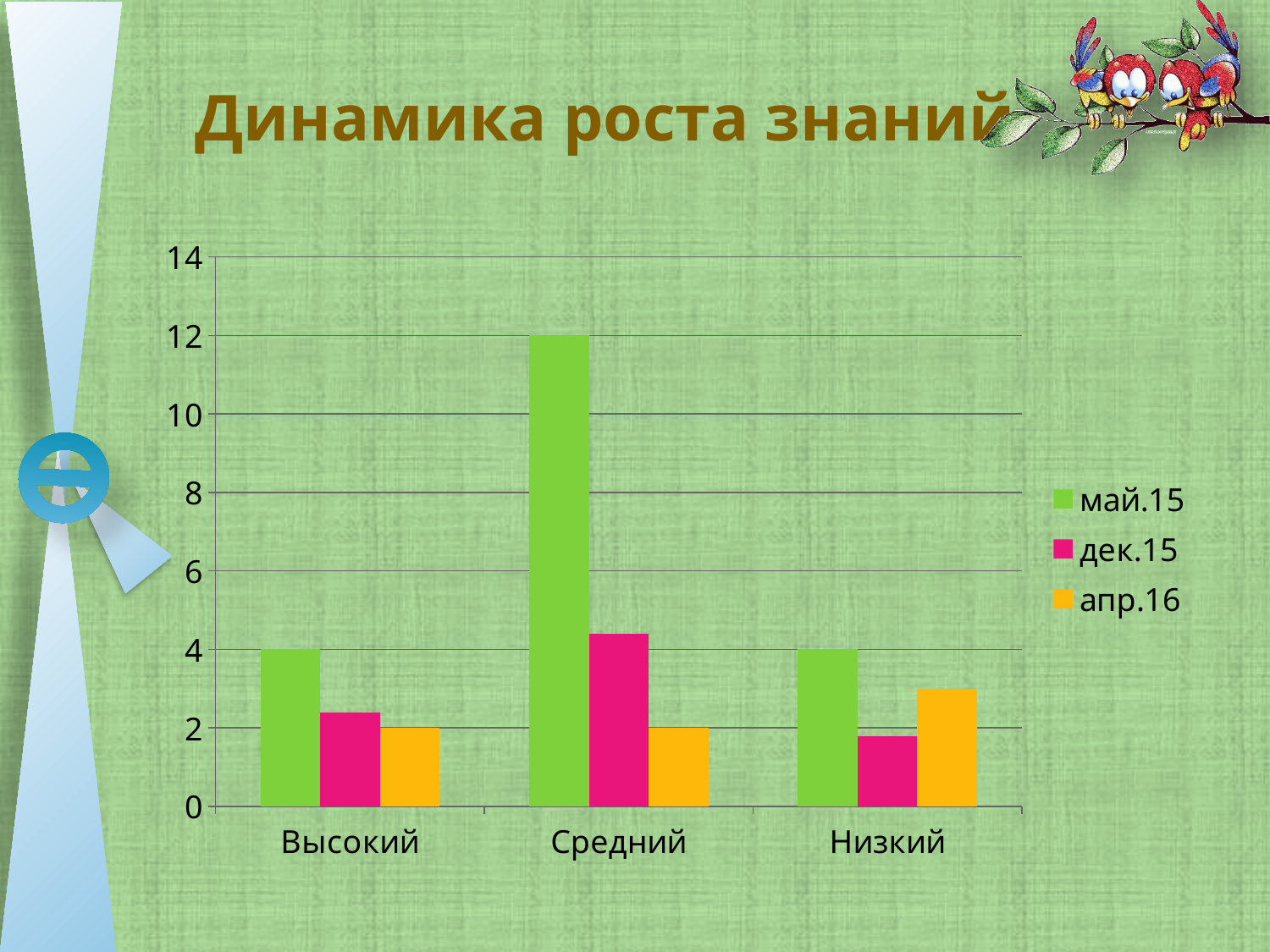
Is the value for апр.16 in the Низкий category greater or less than 2? greater What is the value for апр.16 in the Высокий category? 2 What kind of chart is shown on the slide? bar chart What is the value for май.15 in the Высокий category? 4 What is the value for май.15 in the Средний category? 12 Is the value for дек.15 in the Средний category greater or less than 6? less What is the difference between the май.15 values for Средний and Высокий? 8 How many categories are shown on the x axis? 3 How many series does the legend list? 3 Which category has the highest value for май.15? Средний In the Низкий category, which is larger: май.15 or дек.15? май.15 What is the title of the slide? Динамика роста знаний